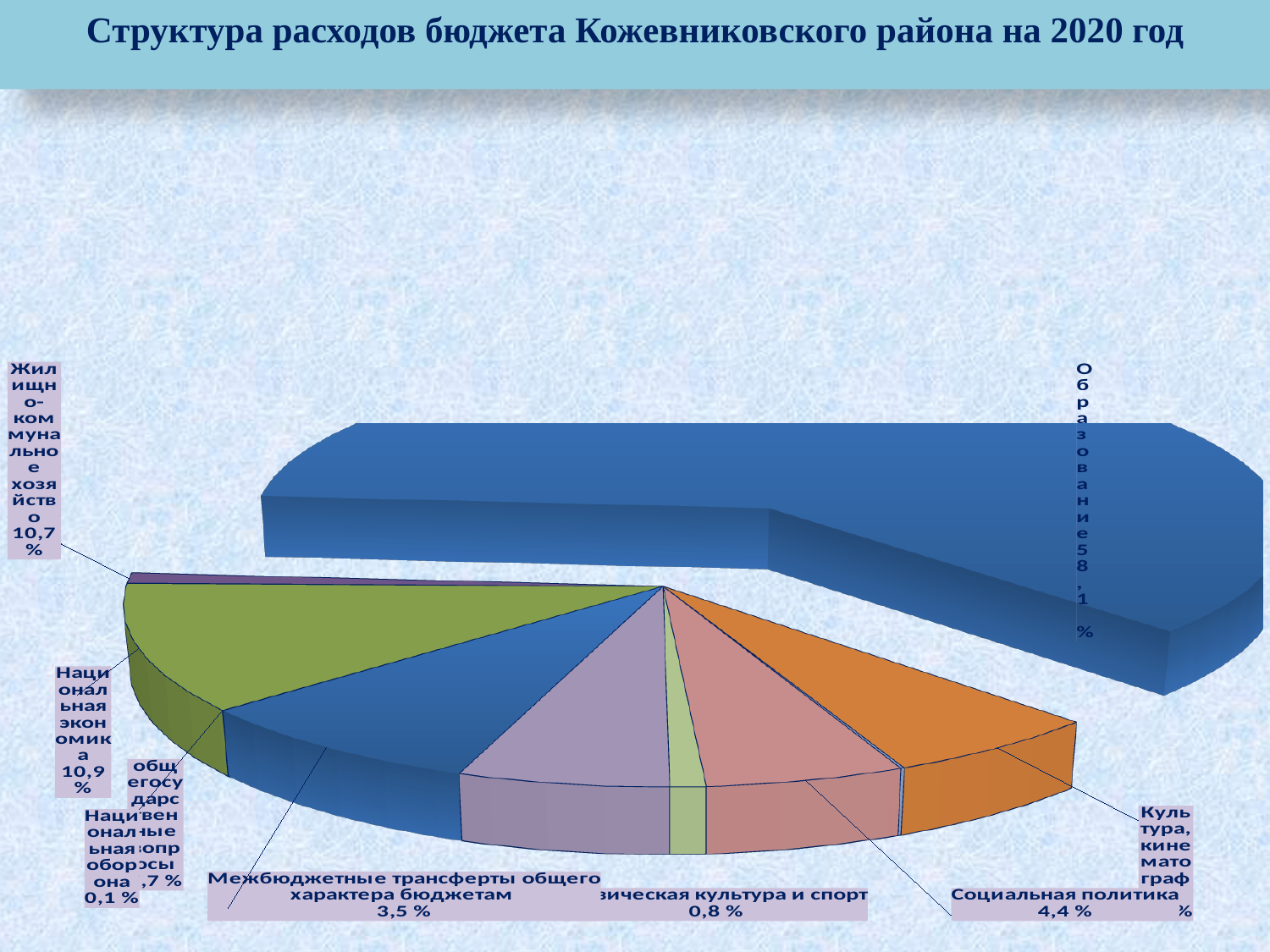
What share of the budget expenditures goes to Национальная оборона? 0,1 % What share of the budget expenditures goes to Образование? 58,1 % Which category has the largest share of the budget expenditures? Образование What share of the budget expenditures goes to Физическая культура и спорт? 0,8 % What share of the budget expenditures goes to Жилищно-коммунальное хозяйство? 10,7 % What share of the budget expenditures goes to Национальная экономика? 10,9 % What share of the budget expenditures goes to Межбюджетные трансферты общего характера бюджетам? 3,5 % What kind of chart is shown on the slide? pie chart What is the title of the chart? Структура расходов бюджета Кожевниковского района на 2020 год What is the difference between the share for Образование and the share for Жилищно-коммунальное хозяйство? 47,4 % Which is larger, the share for Социальная политика or the share for Межбюджетные трансферты общего характера бюджетам? Социальная политика What share of the budget expenditures goes to Социальная политика? 4,4 %